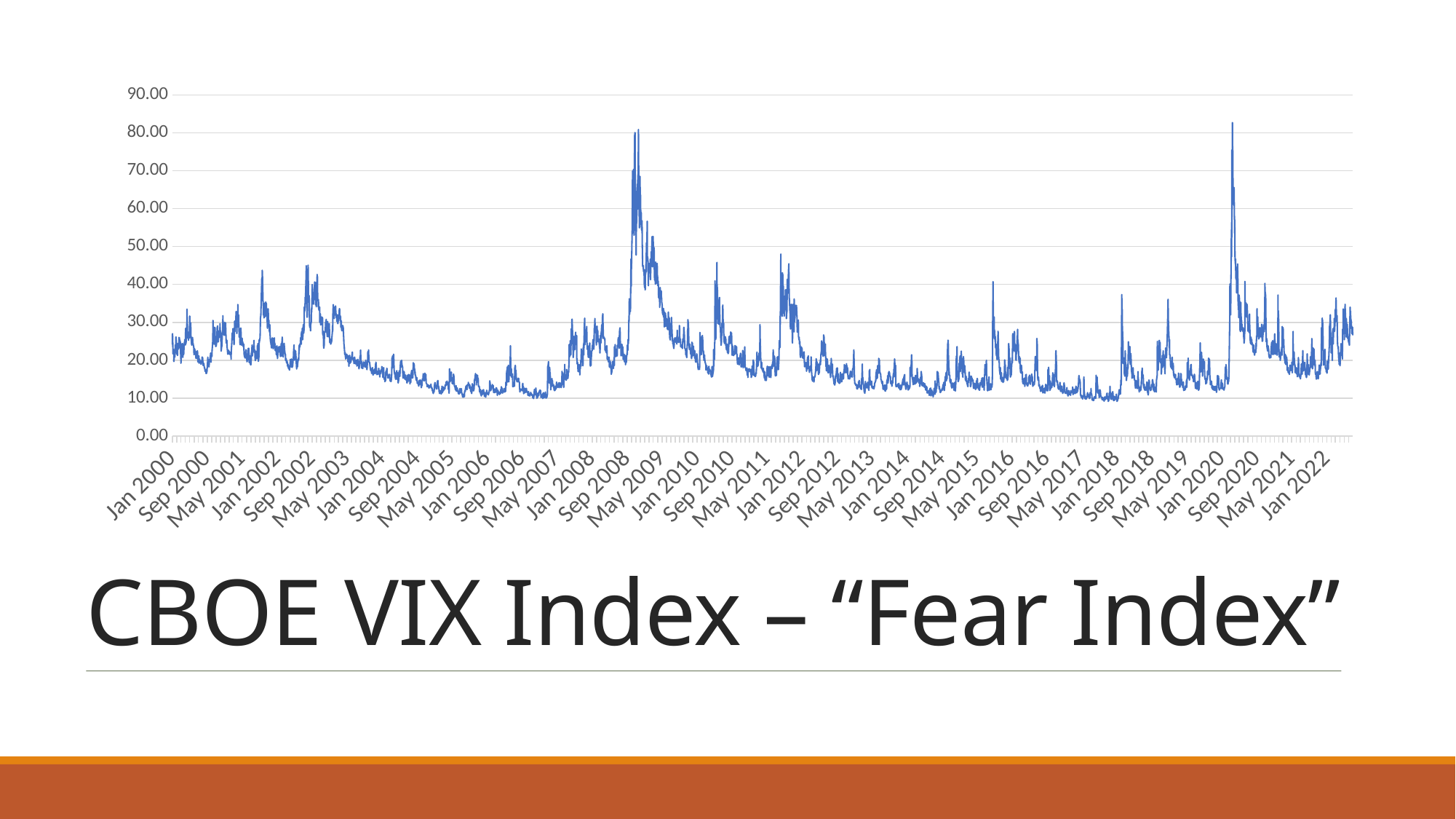
Is the value at Jan 2000 greater or less than 40? less What kind of chart is shown on the slide? line chart What colour is the line on the chart? blue What is the first date label on the horizontal axis? Jan 2000 Does the line ever rise above 80.00 on the chart? yes Does the line ever reach 90.00 on the chart? no What is the title of the slide containing the chart? CBOE VIX Index – "Fear Index" What is the last date label on the horizontal axis? Jan 2022 What is the highest value labelled on the vertical axis? 90.00